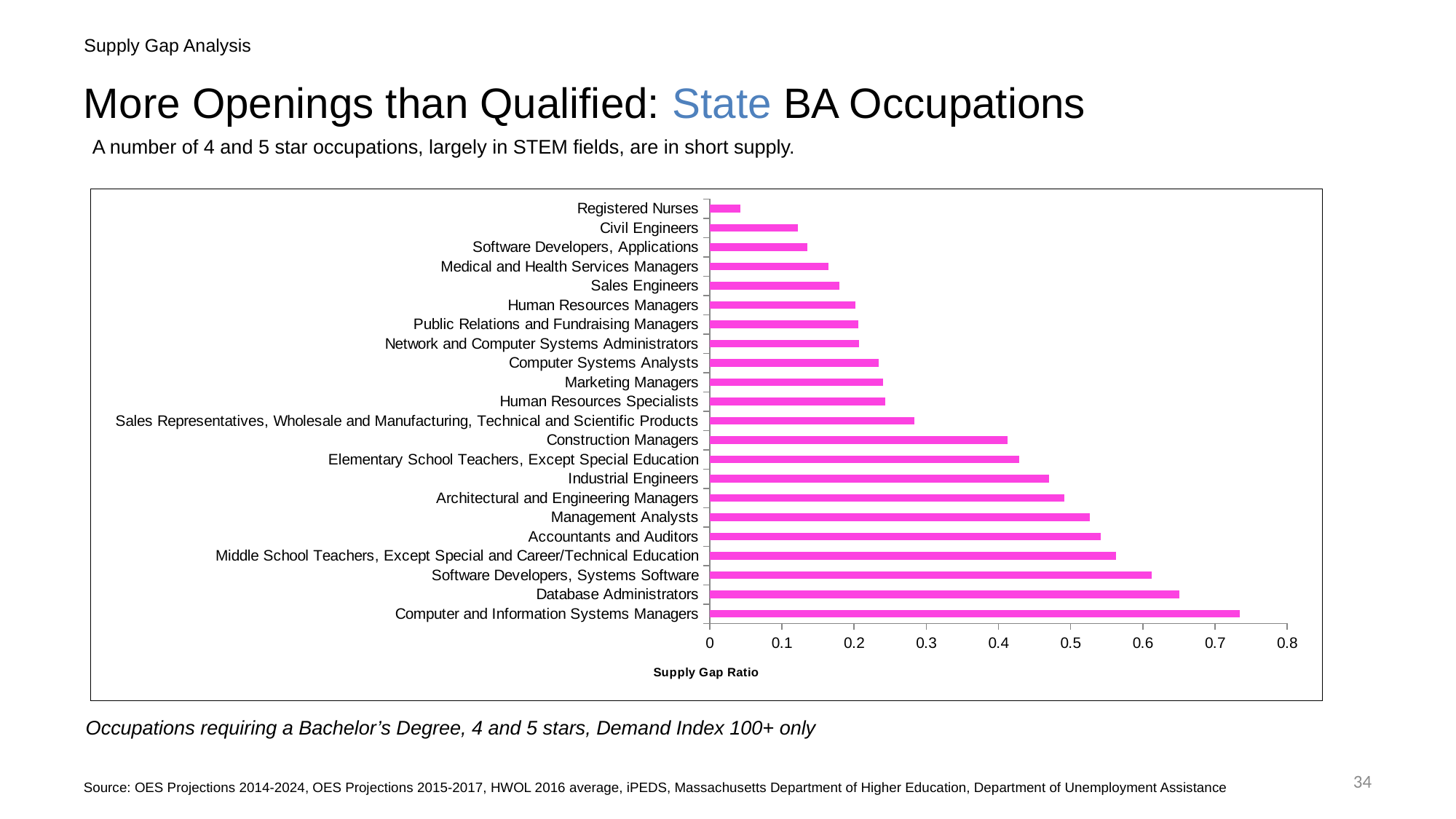
How many occupations are plotted in the chart? 22 Is the supply gap ratio for Industrial Engineers greater or less than 0.5? less Which has a larger supply gap ratio, Database Administrators or Civil Engineers? Database Administrators Is the supply gap ratio for Registered Nurses greater or less than 0.1? less Is the supply gap ratio for Database Administrators greater or less than 0.6? greater Which occupation has the lowest supply gap ratio? Registered Nurses What is the title of the horizontal axis of the chart? Supply Gap Ratio What kind of chart is shown on the slide? bar chart Which occupation has the highest supply gap ratio? Computer and Information Systems Managers Which has a larger supply gap ratio, Management Analysts or Marketing Managers? Management Analysts